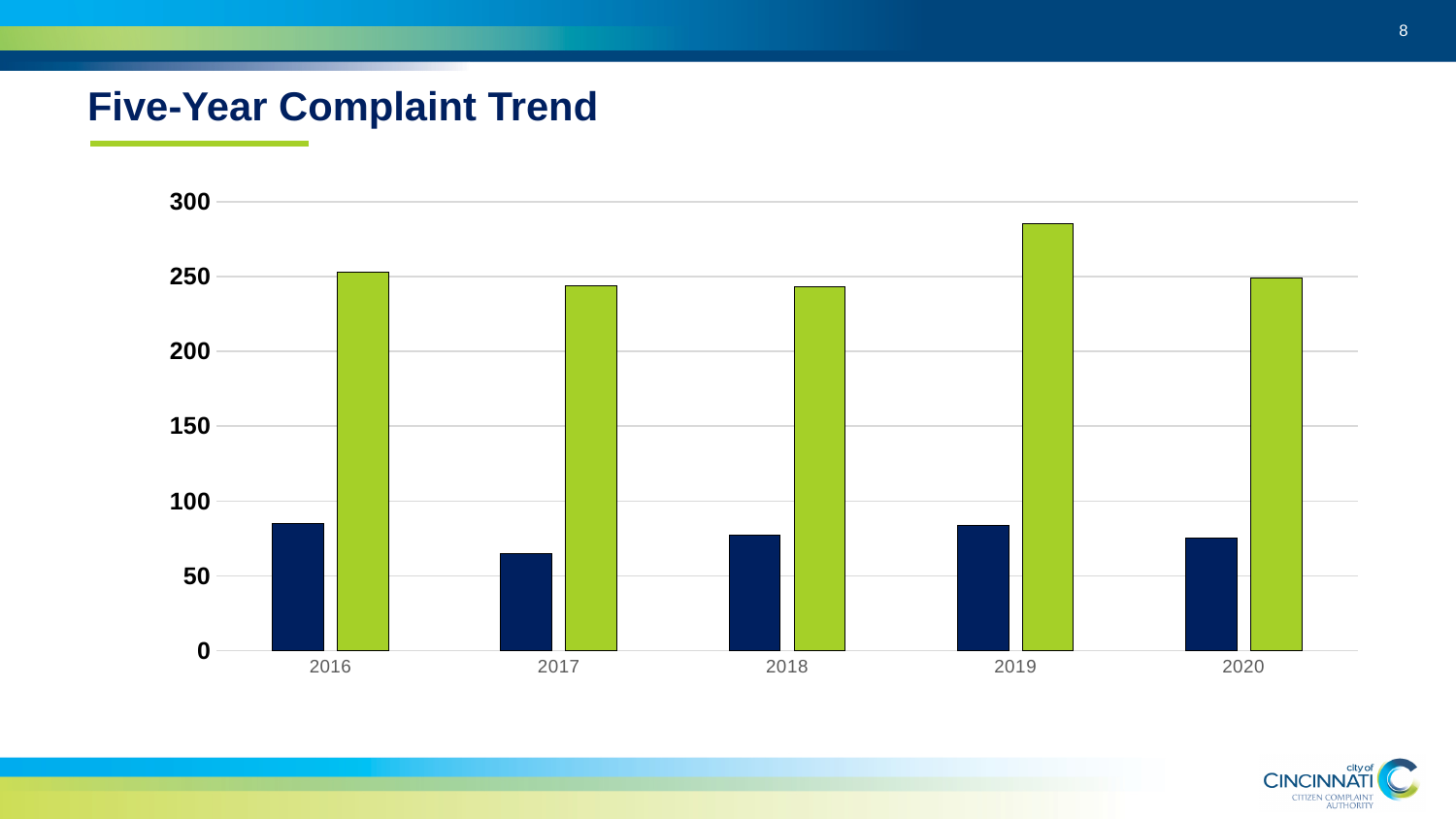
Is the value of the green bar for 2017 greater or less than 250? less Does the green bar rise or fall from 2019 to 2020? fall Is the value of the green bar for 2019 greater or less than 250? greater Is the value of the dark blue bar for 2017 greater or less than 50? greater What is the title of the chart? Five-Year Complaint Trend How many bars are plotted for each year in the chart? 2 What kind of chart is shown on the slide? bar chart In which year is the green bar the highest? 2019 Which is larger, the green bar for 2019 or the green bar for 2016? 2019 In which year is the dark blue bar the lowest? 2017 How many years are shown on the x axis of the chart? 5